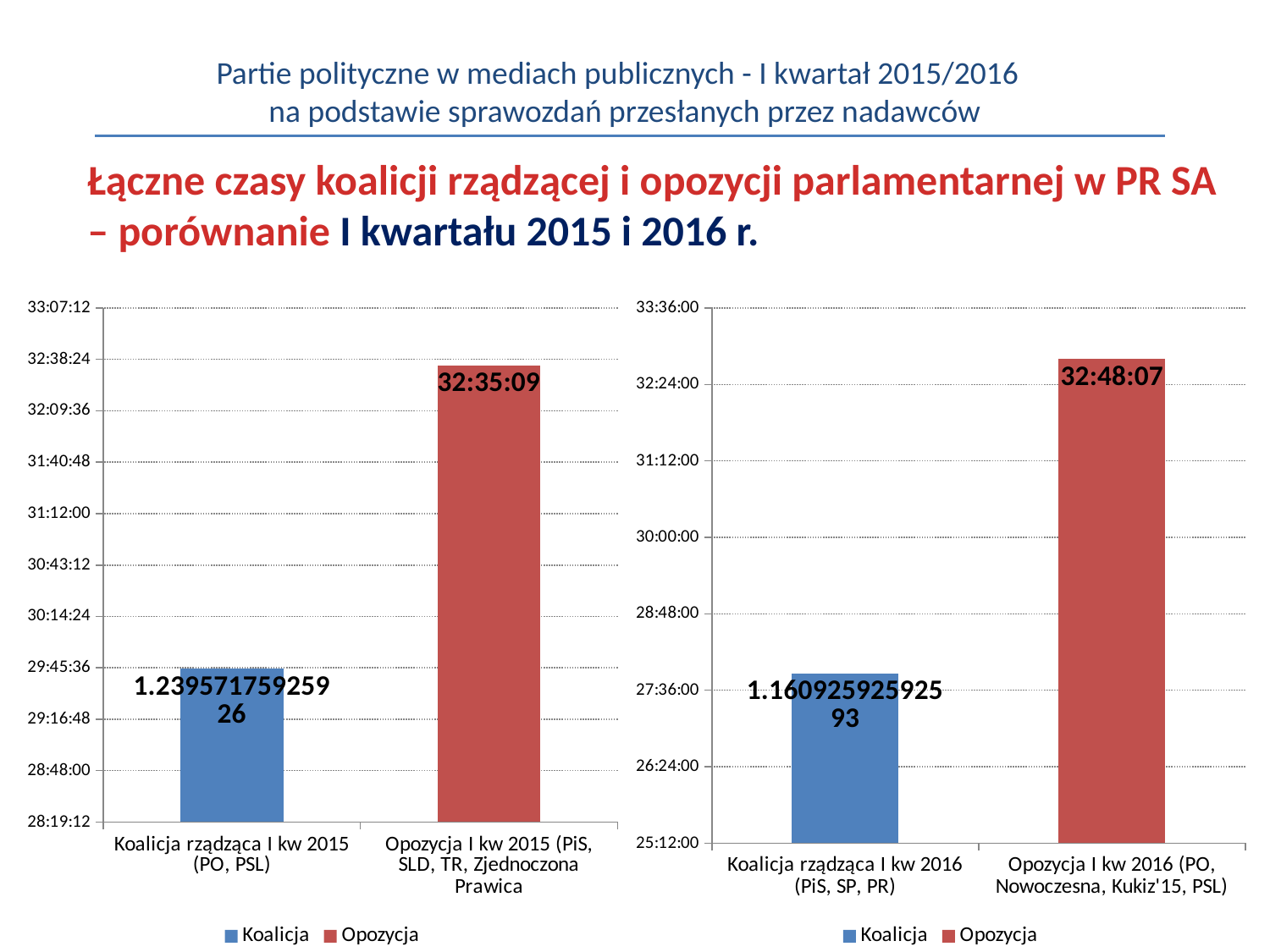
In the right chart (I kw 2016), what data label is printed on the bar for Koalicja rządząca I kw 2016 (PiS, SP, PR)? 1.16092592592593 In the left chart (I kw 2015), what data label is printed on the bar for Koalicja rządząca I kw 2015 (PO, PSL)? 1.23957175925926 In the right chart (I kw 2016), which is larger: the bar for Koalicja rządząca or the bar for Opozycja? Opozycja How many categories are plotted in the left chart (I kw 2015)? 2 In the right chart (I kw 2016), which category has the lowest bar? Koalicja rządząca I kw 2016 (PiS, SP, PR) In the right chart (I kw 2016), what is the value shown for Opozycja I kw 2016 (PO, Nowoczesna, Kukiz'15, PSL)? 32:48:07 In the left chart (I kw 2015), is the bar for Koalicja rządząca I kw 2015 (PO, PSL) greater or less than 30:14:24? less In the right chart (I kw 2016), is the bar for Koalicja rządząca I kw 2016 (PiS, SP, PR) greater or less than 28:48:00? less In the left chart (I kw 2015), what is the value shown for Opozycja I kw 2015 (PiS, SLD, TR, Zjednoczona Prawica)? 32:35:09 In the left chart (I kw 2015), which category has the highest bar? Opozycja I kw 2015 (PiS, SLD, TR, Zjednoczona Prawica) What type of chart is the left chart (I kw 2015)? Bar chart How many series does the legend of the right chart (I kw 2016) list? 2